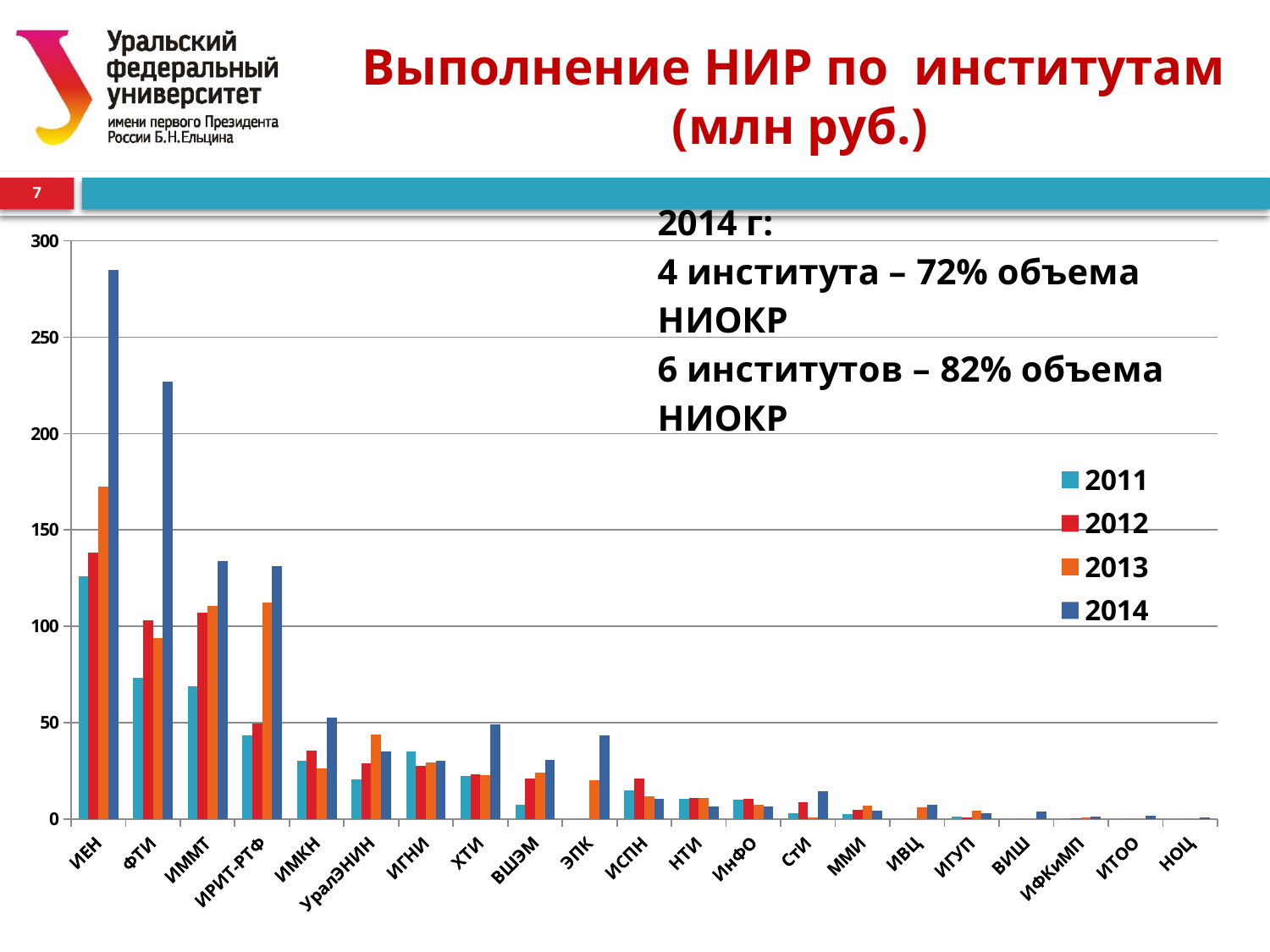
Which is larger, the 2014 value for ФТИ or the 2014 value for ИММТ? ФТИ Is the 2014 value for ФТИ greater or less than 200? greater Is the 2013 value for ФТИ greater or less than 100? less Do the values for ИЕН rise or fall from 2011 to 2014? rise What kind of chart is shown on the slide? bar chart Is the 2014 value for ЭПК greater or less than 50? less Which institute has the highest value for 2013? ИЕН How many series does the legend list? 4 Which colour represents the 2014 series in the legend? blue How many institutes (categories) are shown on the x axis? 21 Which institute has the highest value for 2014? ИЕН